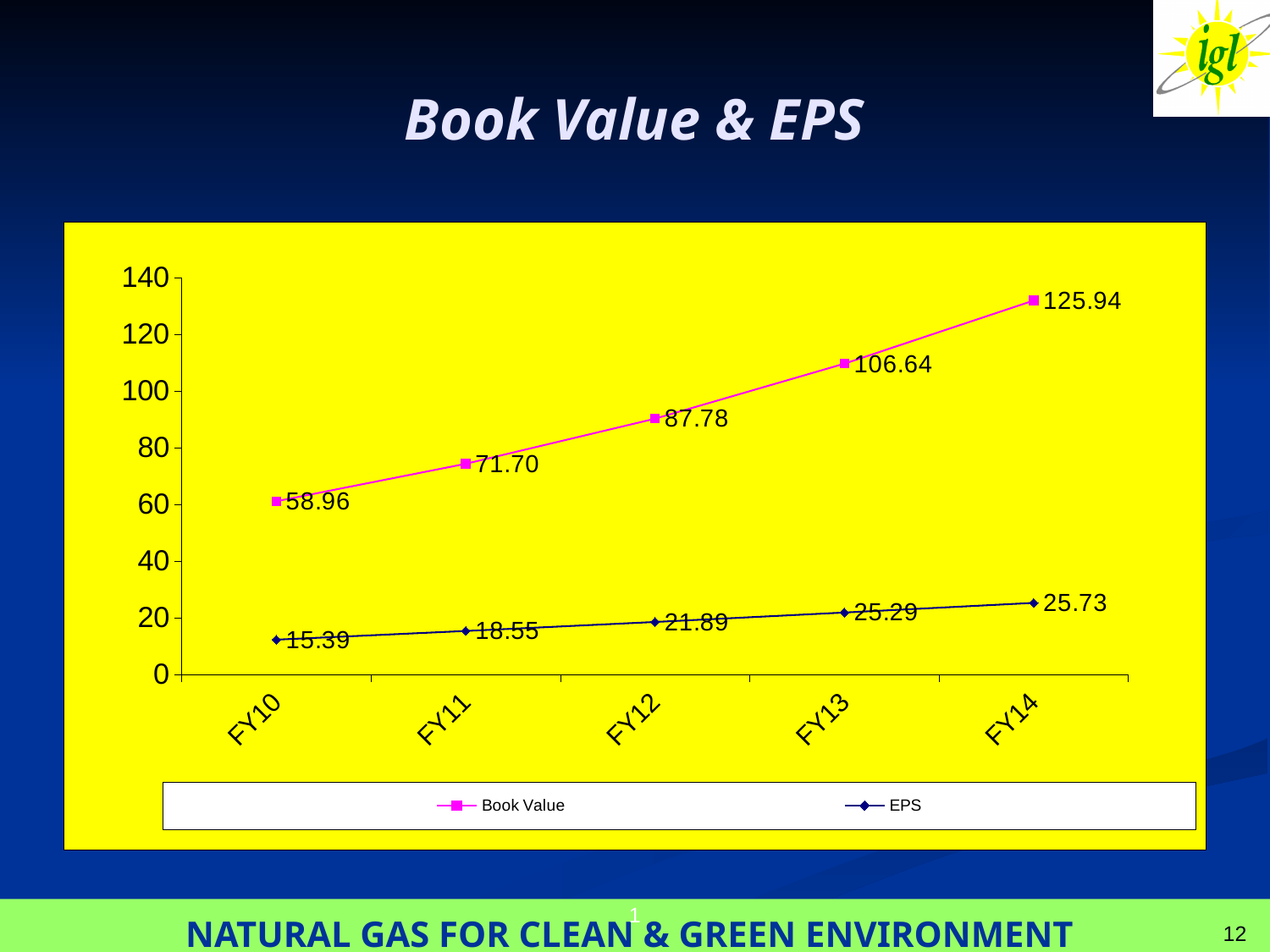
How many series does the legend list? 2 What is the EPS for FY10? 15.39 Does the Book Value rise or fall from FY10 to FY14? Rise In which fiscal year is the EPS lowest? FY10 What is the Book Value for FY12? 87.78 Which is larger, the EPS in FY12 or the EPS in FY11? EPS in FY12 What is the EPS for FY13? 25.29 How many fiscal years are shown on the x axis? 5 What is the Book Value for FY14? 125.94 In which fiscal year is the Book Value highest? FY14 What kind of chart is shown on the slide? Line chart What is the difference between the Book Value in FY14 and FY13? 19.30